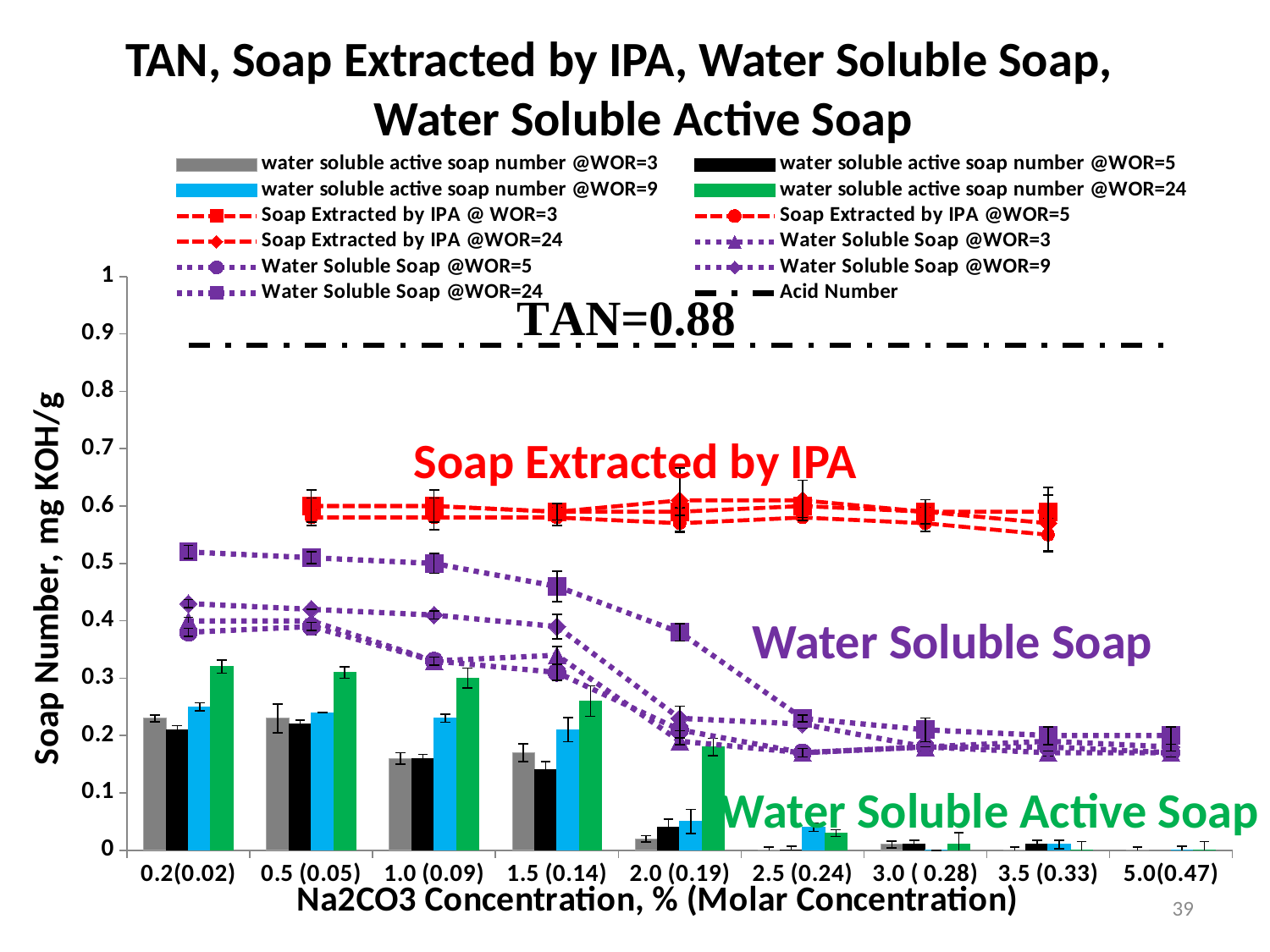
What is the y-axis title of the chart? Soap Number, mg KOH/g Is the value for water soluble active soap number @WOR=24 at 0.2(0.02) greater or less than 0.2? greater Is the value for Water Soluble Soap @WOR=24 at 0.2(0.02) greater or less than 0.4? greater Is the value for Soap Extracted by IPA @ WOR=3 at 0.5 (0.05) greater or less than 0.5? greater What value is given for TAN on the chart? 0.88 Does the Water Soluble Soap @WOR=24 series rise or fall as Na2CO3 concentration increases? fall Which water soluble active soap number series has the lowest bar at 1.5 (0.14)? water soluble active soap number @WOR=5 How many Na2CO3 concentration categories are shown on the x axis? 9 What kind of chart is shown on the slide? Combined bar and line chart How many series does the legend list? 12 Which water soluble active soap number series has the highest bar at 1.5 (0.14)? water soluble active soap number @WOR=24